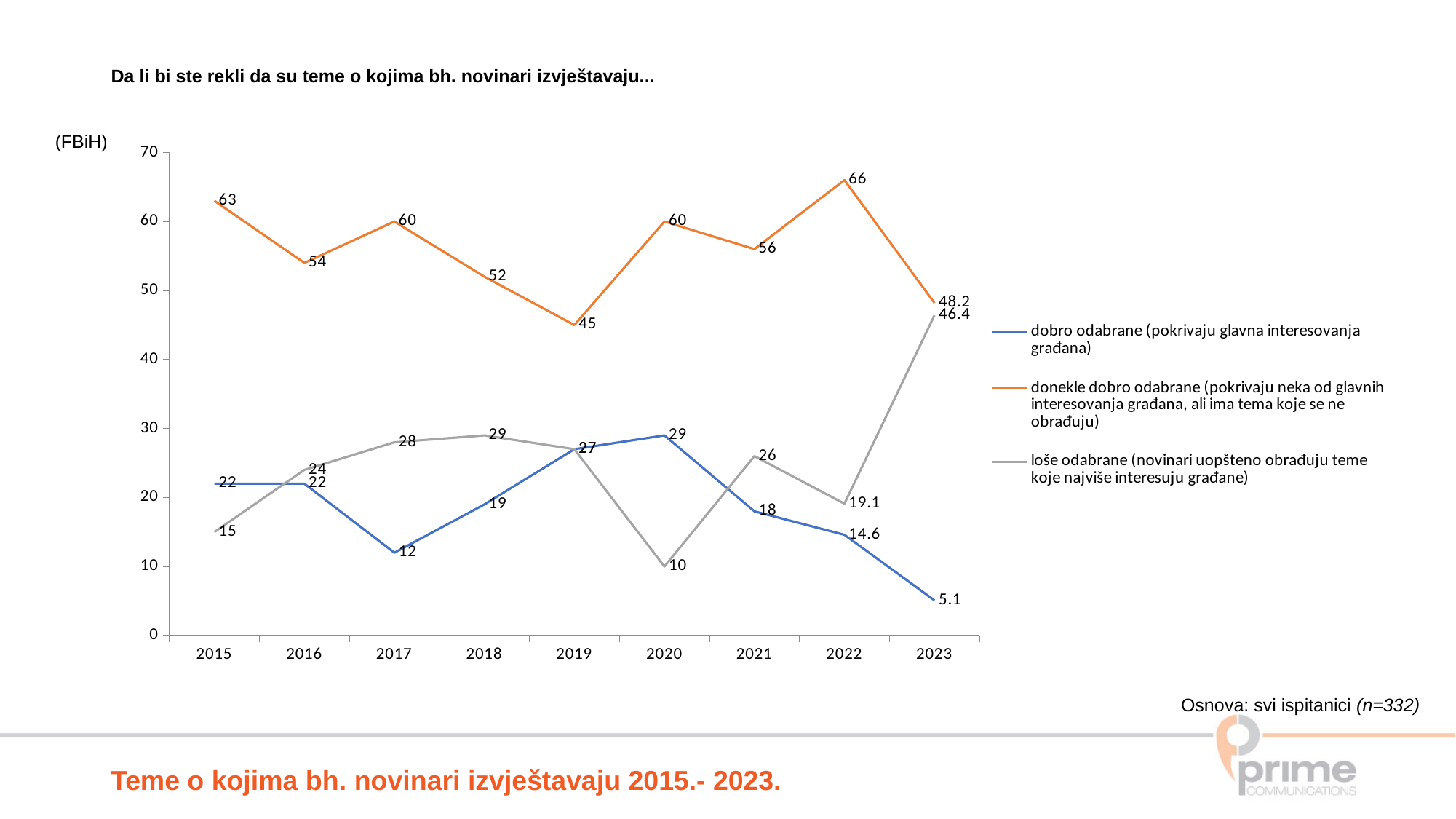
What is the value for 'donekle dobro odabrane' in 2022? 66 In 2023, which series has the larger value: 'donekle dobro odabrane' or 'loše odabrane'? donekle dobro odabrane What is the value for 'loše odabrane' in 2020? 10 What is the value for 'loše odabrane' in 2023? 46.4 What is the difference between the 'donekle dobro odabrane' values for 2022 and 2023? 17.8 In which year is the 'donekle dobro odabrane' series highest? 2022 How many series does the legend list? 3 Does the 'dobro odabrane' series rise or fall from 2020 to 2023? fall How many years are shown on the x axis? 9 What is the value for 'dobro odabrane' in 2023? 5.1 In which year is the 'dobro odabrane' series lowest? 2023 What kind of chart is shown on the slide? line chart